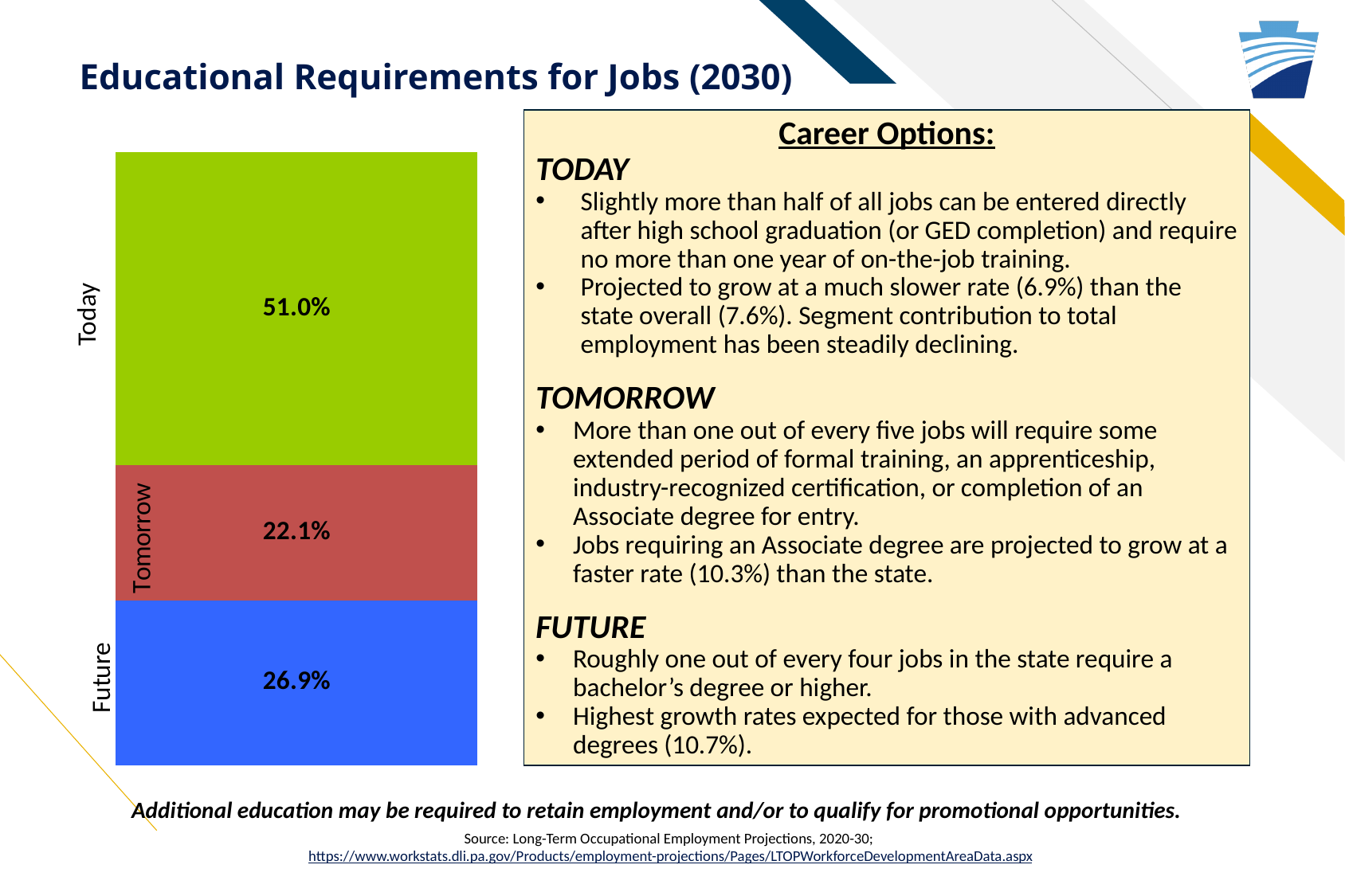
Which segment of the stacked bar has the smallest share? Tomorrow What is the total of the three segments in the stacked bar? 100.0% What kind of chart is shown on the slide? Stacked bar chart Which is larger, the Future segment or the Tomorrow segment? Future What colour is the Today segment of the stacked bar? Green What percentage is shown for the Future segment of the stacked bar? 26.9% What is the difference in percentage points between the Future and Tomorrow segments? 4.8 What is the difference in percentage points between the Today and Future segments? 24.1 What percentage is shown for the Today segment of the stacked bar? 51.0% How many segments make up the stacked bar? 3 What percentage is shown for the Tomorrow segment of the stacked bar? 22.1% Which segment of the stacked bar has the largest share? Today